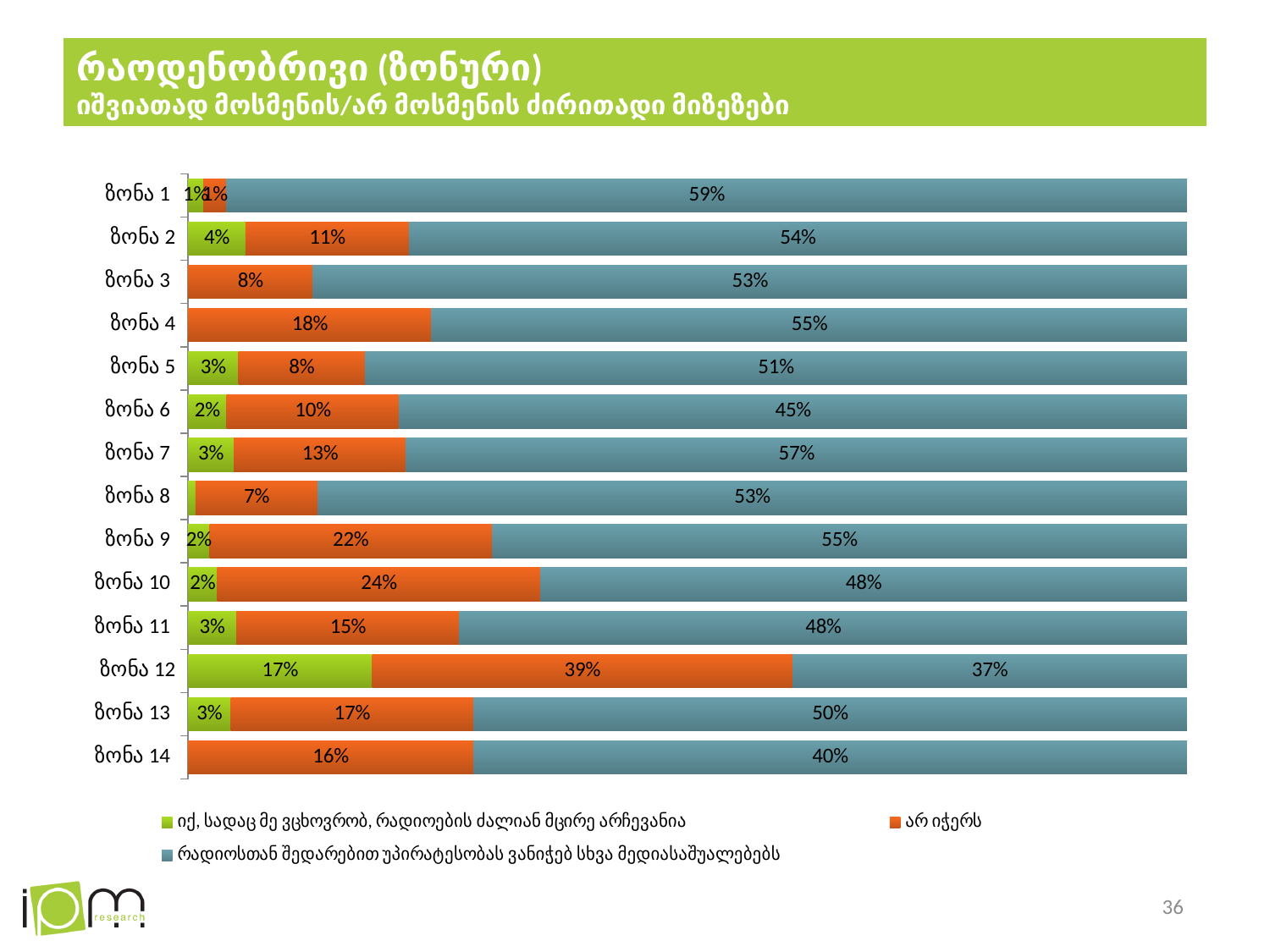
How many series does the legend list? 3 Which zone has the lowest value for the blue series? ზონა 12 How many zones are shown on the chart? 14 Which zone has the highest value for the orange series (არ იჭერს)? ზონა 12 What is the value of the blue series (რადიოსთან შედარებით უპირატესობას ვანიჭებ სხვა მედიასაშუალებებს) for ზონა 1? 59% What is the value of the orange series (არ იჭერს) for ზონა 10? 24% Which is larger: the orange value for ზონა 9 or the orange value for ზონა 4? ზონა 9 What is the difference between the orange value and the blue value for ზონა 12? 2% Which zone has the highest value for the blue series? ზონა 1 What is the value of the green series for ზონა 12? 17% What kind of chart is shown on the slide? Stacked bar chart What is the value of the orange series (არ იჭერს) for ზონა 14? 16%